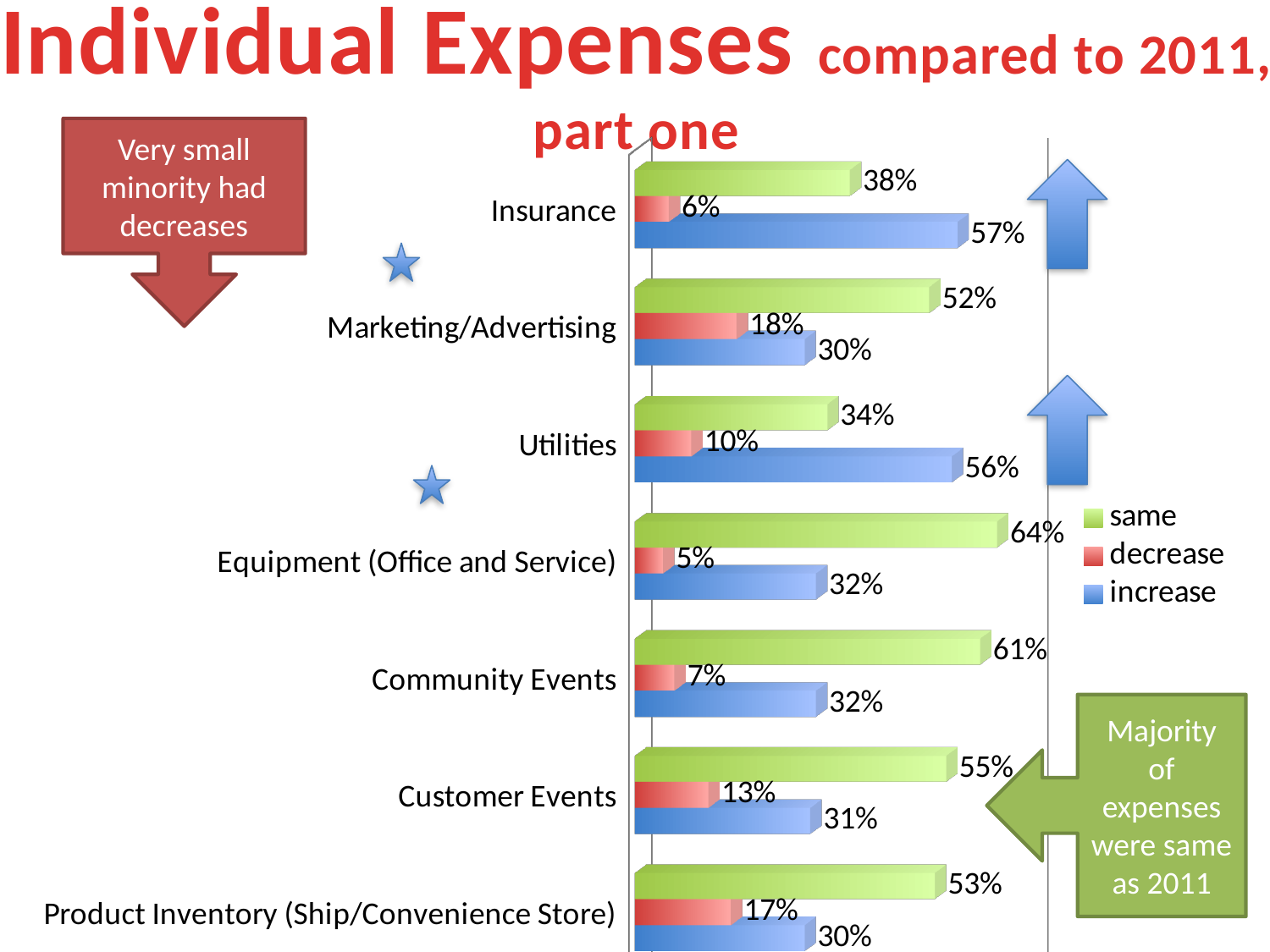
What type of chart is shown on the slide? bar chart What percentage reported a decrease in Marketing/Advertising expenses? 18% Which is larger for Utilities: the 'same' value or the 'increase' value? increase How many series does the legend list? 3 What colour represents the 'decrease' series in the legend? red Which category has the highest 'same' value? Equipment (Office and Service) What percentage of respondents reported an increase in Insurance expenses? 57% What is the 'same' value for Equipment (Office and Service)? 64% Which category has the lowest 'decrease' value? Equipment (Office and Service) Which category has the highest 'increase' value? Insurance What is the difference between the 'same' and 'increase' values for Community Events? 29% How many expense categories are shown in the chart? 7